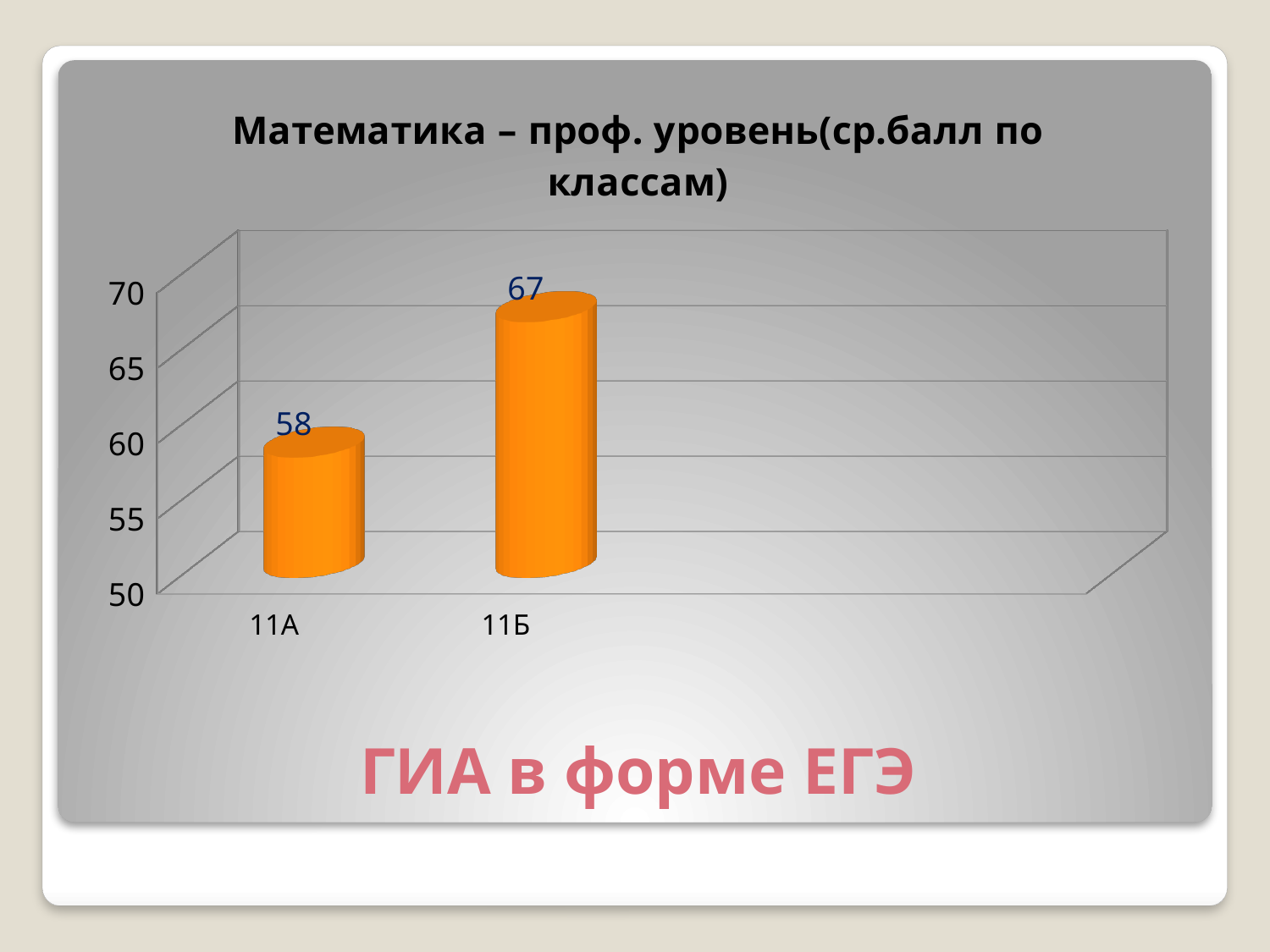
What is the average score for class 11А? 58 What is the title of the chart? Математика – проф. уровень(ср.балл по классам) Do the values rise or fall from 11А to 11Б? rise What is the average score for class 11Б? 67 What is the difference between the average scores of 11Б and 11А? 9 Which class has the larger average score, 11А or 11Б? 11Б Is the value for 11А greater or less than 60? less Which class has the lowest average score? 11А Is the value for 11Б greater or less than 65? greater What kind of chart is shown on the slide? bar chart Which class has the highest average score? 11Б How many classes are shown in the chart? 2